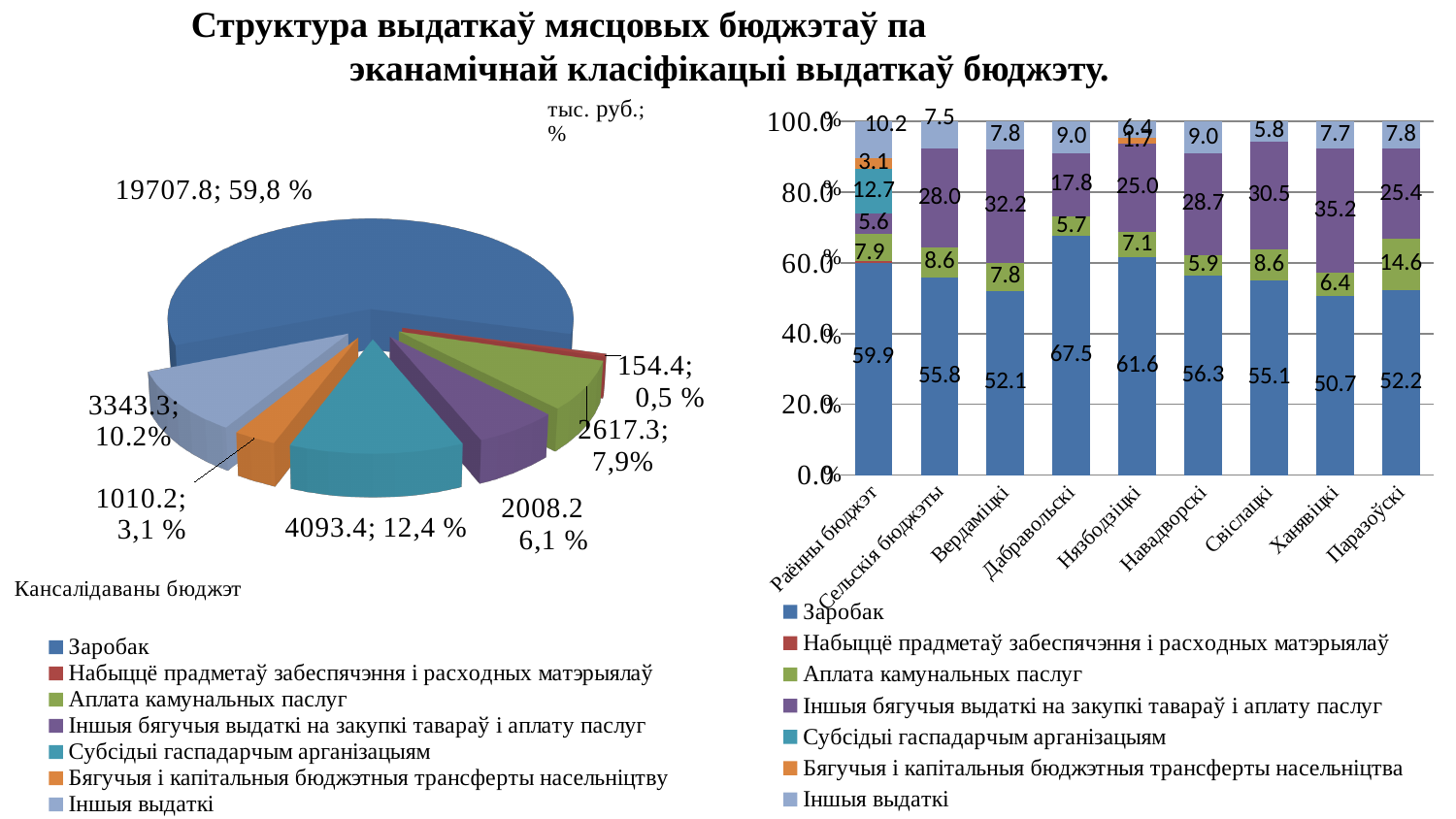
How many budgets (categories) are shown on the x axis of the right stacked bar chart? 9 In the right stacked bar chart, which budget has the highest Заробак value? Дабравольскі What kind of chart is the left chart (Кансалідаваны бюджэт)? pie chart How many series does the legend of the right stacked bar chart list? 7 How many slices does the left pie chart (Кансалідаваны бюджэт) have? 7 In the right stacked bar chart, what is the value of Заробак for Дабравольскі? 67.5 In the left pie chart (Кансалідаваны бюджэт), what is the value in тыс. руб. for Субсідыі гаспадарчым арганізацыям? 4093.4 What kind of chart is the right chart? stacked bar chart In the right stacked bar chart, what is the difference between the Заробак values for Дабравольскі and Ханявіцкі? 16.8 In the right stacked bar chart, which budget has the lowest Заробак value? Ханявіцкі In the left pie chart (Кансалідаваны бюджэт), which category has the smallest slice? Набыццё прадметаў забеспячэння і расходных матэрыялаў In the left pie chart (Кансалідаваны бюджэт), what share does Заробак have? 59,8 %